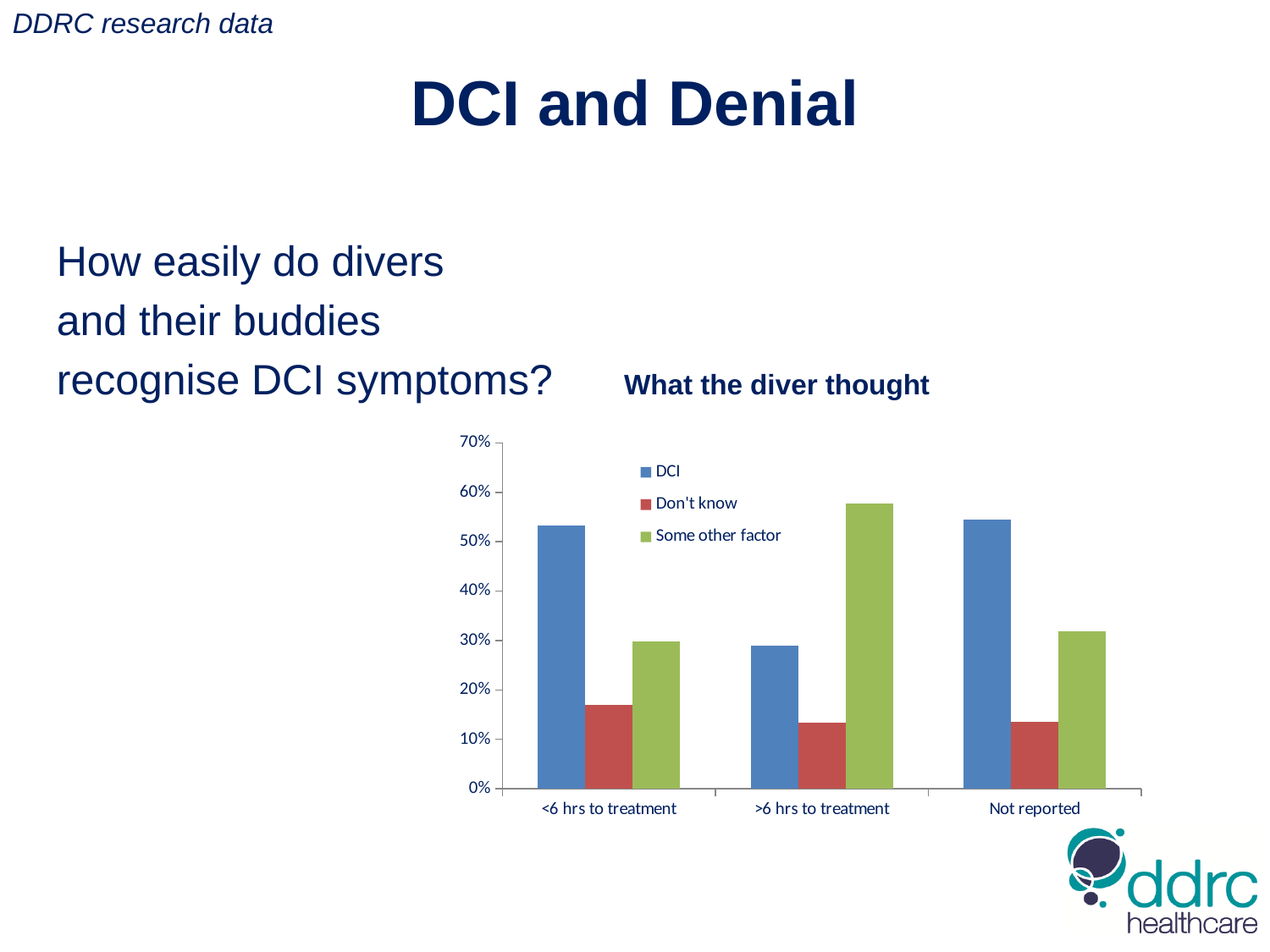
What kind of chart is shown under the title 'What the diver thought'? bar chart Is the value for 'DCI' in the '>6 hrs to treatment' category greater or less than 40%? less How many series does the legend of the 'What the diver thought' chart list? 3 Which is larger: the 'DCI' value for '<6 hrs to treatment' or the 'DCI' value for '>6 hrs to treatment'? <6 hrs to treatment Is the value for 'Some other factor' in the '>6 hrs to treatment' category greater or less than 50%? greater Is the value for 'Don't know' in the 'Not reported' category greater or less than 20%? less How many categories are shown on the x axis of the 'What the diver thought' chart? 3 Which is larger: the 'Some other factor' value for '>6 hrs to treatment' or the 'Some other factor' value for 'Not reported'? >6 hrs to treatment Which series has the shortest bar in the '<6 hrs to treatment' category? Don't know Which series has the tallest bar in the '>6 hrs to treatment' category? Some other factor What colour are the 'Some other factor' bars in the chart? green